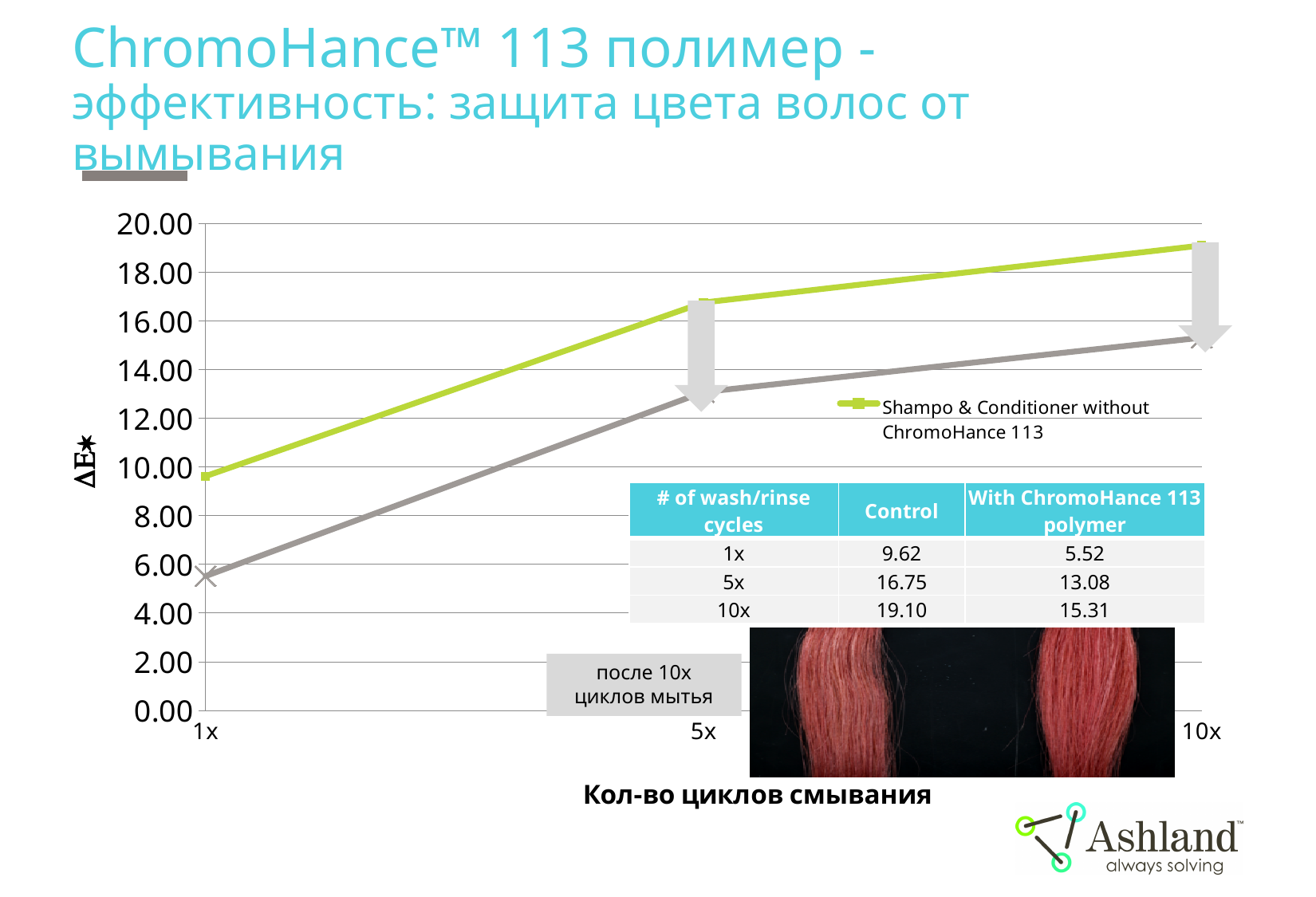
How many wash/rinse cycle categories are shown on the x axis of the chart? 3 What is the difference between the Control and the ChromoHance 113 polymer ΔE* values after 1x cycle? 4.10 What is the ΔE* value with ChromoHance 113 polymer after 5x wash/rinse cycles? 13.08 What is the ΔE* value with ChromoHance 113 polymer after 10x wash/rinse cycles? 15.31 What kind of chart is shown on the slide? line chart After 5x wash/rinse cycles, which has the higher ΔE*: the Control or the ChromoHance 113 polymer? Control What is the difference between the Control and the ChromoHance 113 polymer ΔE* values after 10x cycles? 3.79 Do the ΔE* values rise or fall as the number of wash/rinse cycles increases? rise What is the label on the y axis of the chart? ΔE* What is the ΔE* value for the Control after 1x wash/rinse cycle? 9.62 What is the ΔE* value for the Control after 5x wash/rinse cycles? 16.75 How many lines are plotted on the chart? 2